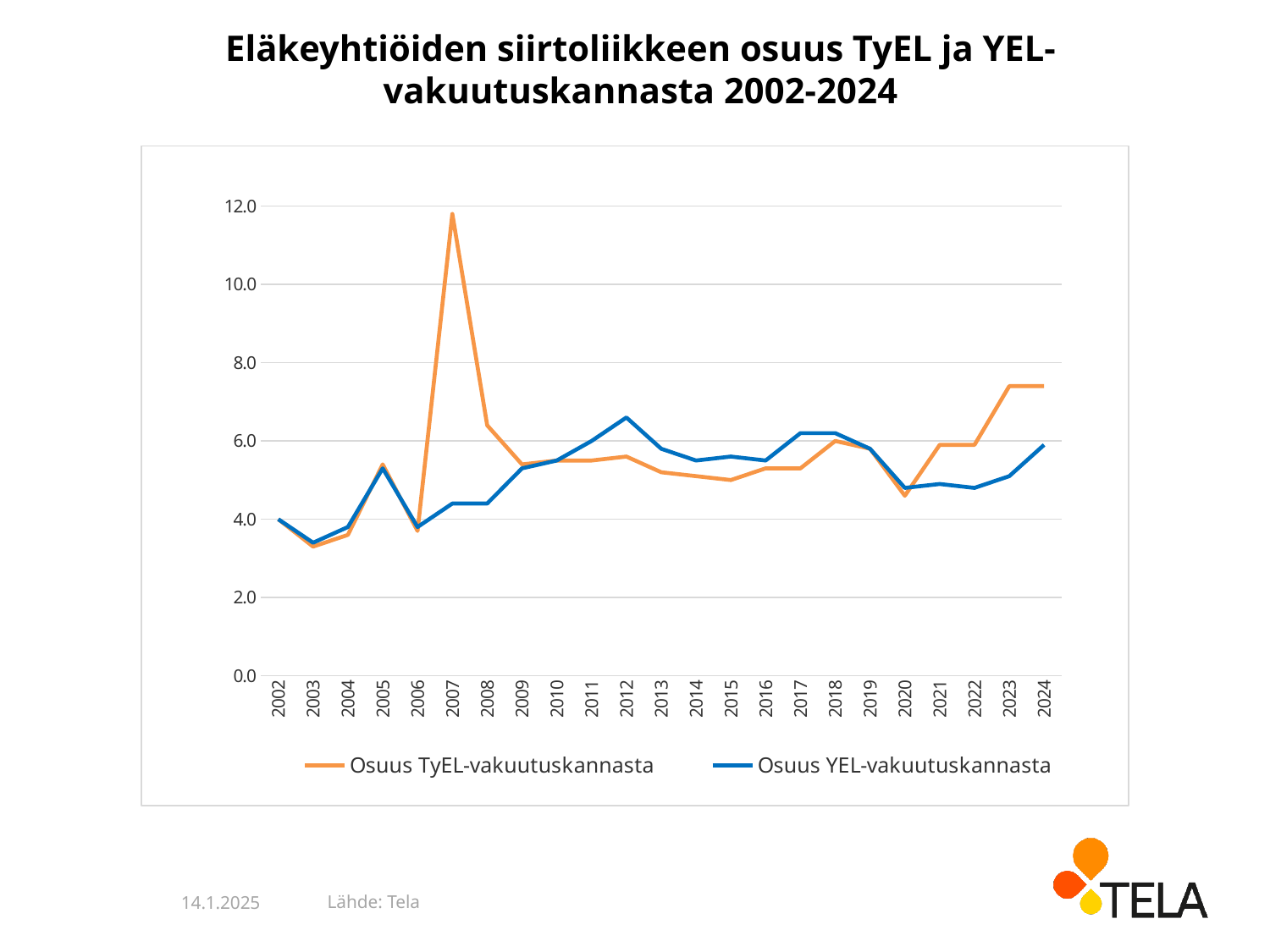
What colour is the line for Osuus YEL-vakuutuskannasta? blue Is the value for Osuus YEL-vakuutuskannasta in 2020 greater or less than 6.0? less Is the value for Osuus TyEL-vakuutuskannasta in 2007 greater or less than 10.0? greater How many series does the legend list? 2 How many years are plotted along the x axis? 23 Does the Osuus TyEL-vakuutuskannasta series rise or fall from 2020 to 2023? rise In which year is the Osuus TyEL-vakuutuskannasta series at its lowest? 2003 In 2012, which series has the larger value, Osuus TyEL-vakuutuskannasta or Osuus YEL-vakuutuskannasta? Osuus YEL-vakuutuskannasta In which year does the Osuus TyEL-vakuutuskannasta series reach its highest value? 2007 Is the value for Osuus TyEL-vakuutuskannasta in 2023 greater or less than 6.0? greater What kind of chart is shown on the slide? line chart In which year does the Osuus YEL-vakuutuskannasta series reach its highest value? 2012